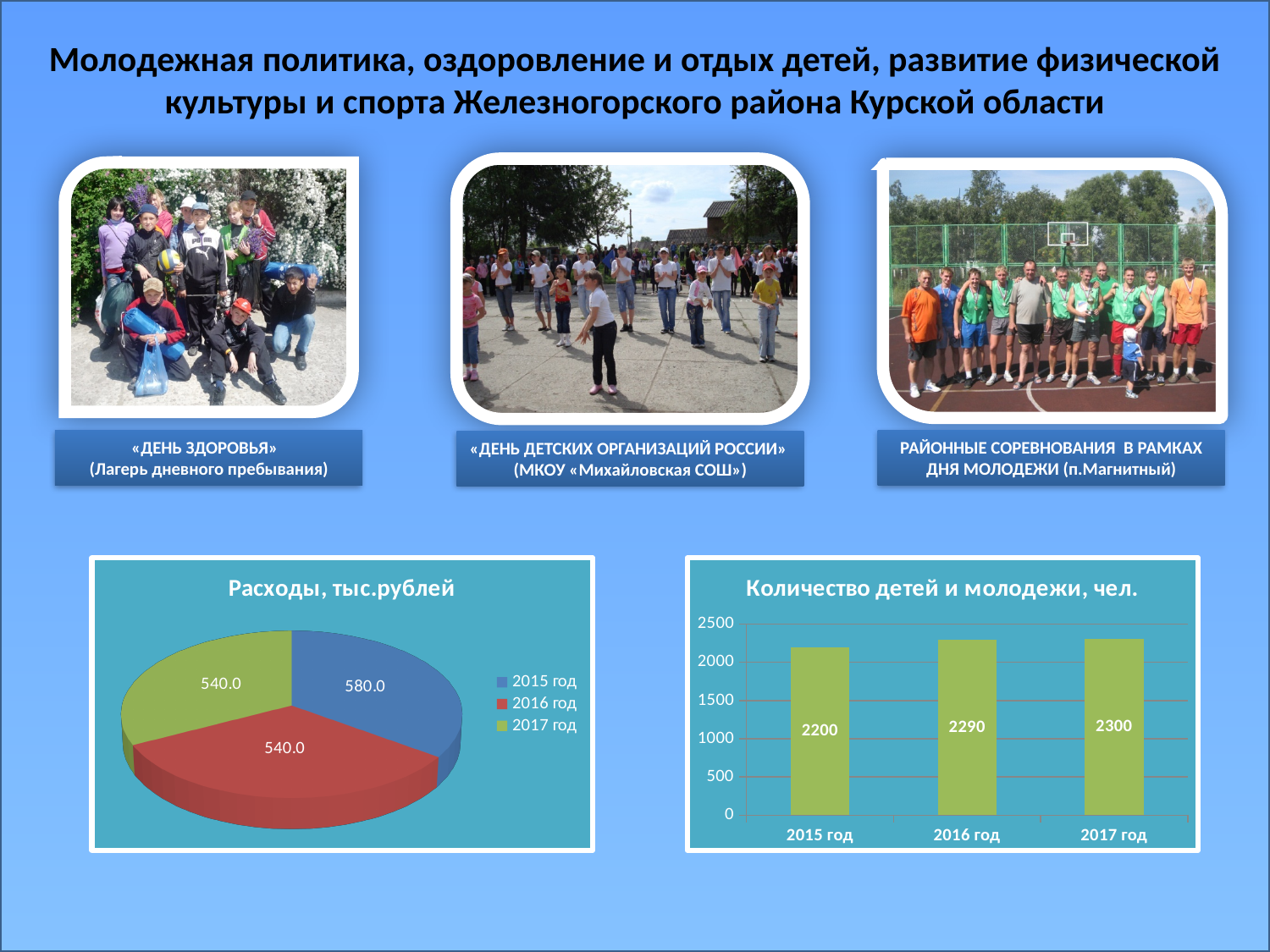
In the chart titled "Расходы, тыс.рублей", what is the value for 2015 год? 580.0 In the chart titled "Количество детей и молодежи, чел.", what is the value for 2016 год? 2290 What kind of chart is the one titled "Расходы, тыс.рублей"? pie chart In the chart titled "Количество детей и молодежи, чел.", which year has the highest value? 2017 год In the chart titled "Количество детей и молодежи, чел.", what is the difference between the values for 2017 год and 2015 год? 100 In the chart titled "Количество детей и молодежи, чел.", which year has the lowest value? 2015 год In the chart titled "Расходы, тыс.рублей", what is the value for 2016 год? 540.0 How many entries does the legend of the chart titled "Расходы, тыс.рублей" list? 3 In the chart titled "Расходы, тыс.рублей", what is the difference between the values for 2015 год and 2017 год? 40.0 In the chart titled "Расходы, тыс.рублей", which year has the largest slice? 2015 год In the chart titled "Количество детей и молодежи, чел.", do the values rise or fall from 2015 год to 2017 год? rise What kind of chart is the one titled "Количество детей и молодежи, чел."? bar chart